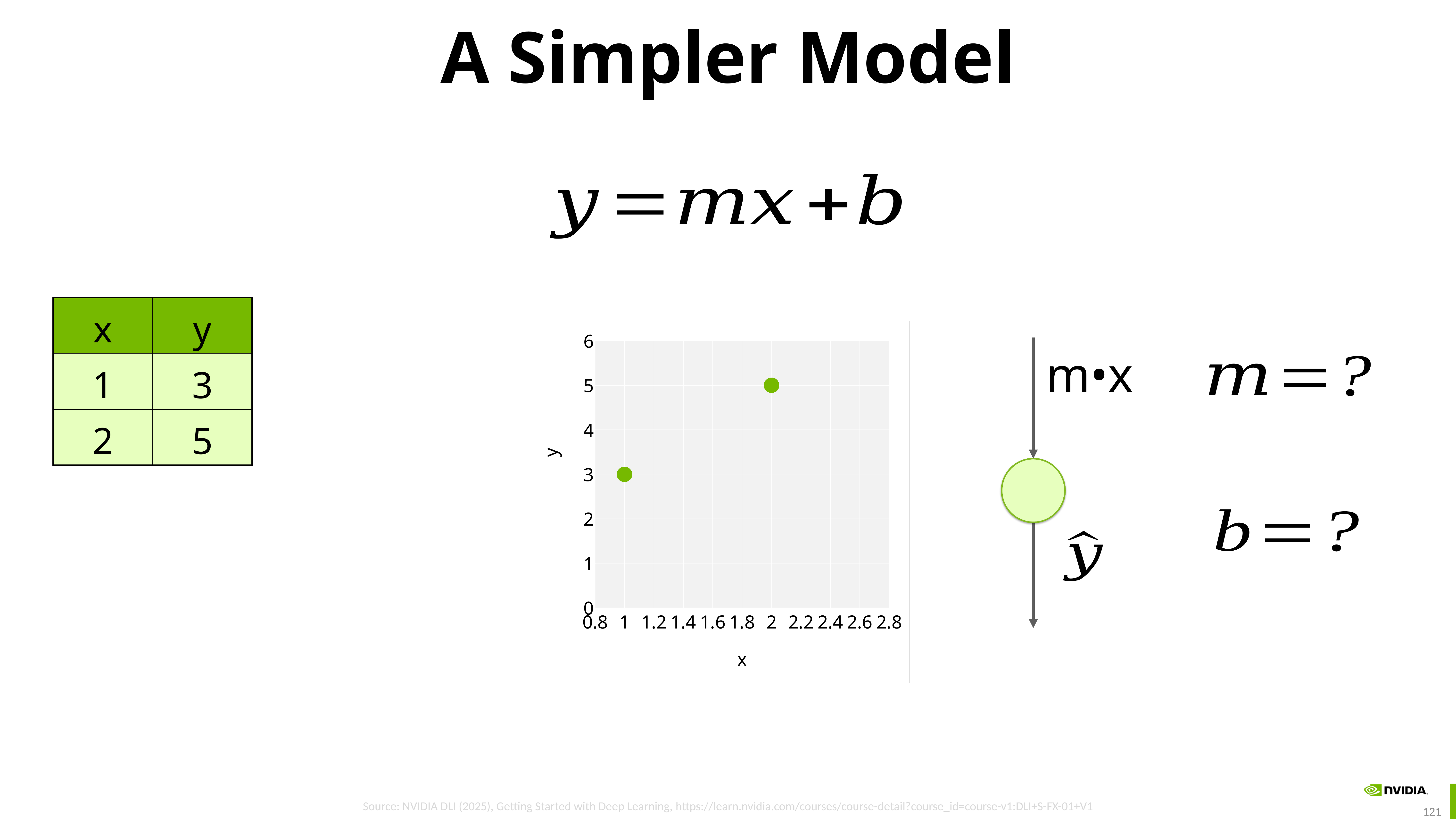
Do the y values rise or fall as x increases along the x axis? rise What is the y value of the point at x = 1? 3 Which x value has the lowest y value on the chart? 1 What is the highest value shown on the y axis of the chart? 6 What is the difference between the y values at x = 2 and x = 1? 2 Which x value has the highest y value on the chart? 2 What is the y value of the point at x = 2? 5 Is the y value of the point at x = 2 greater or less than 4? greater What is the label of the vertical axis of the chart? y What kind of chart is shown on the slide? scatter chart How many data points are plotted on the chart? 2 Which point has a larger y value, the one at x = 1 or the one at x = 2? x = 2